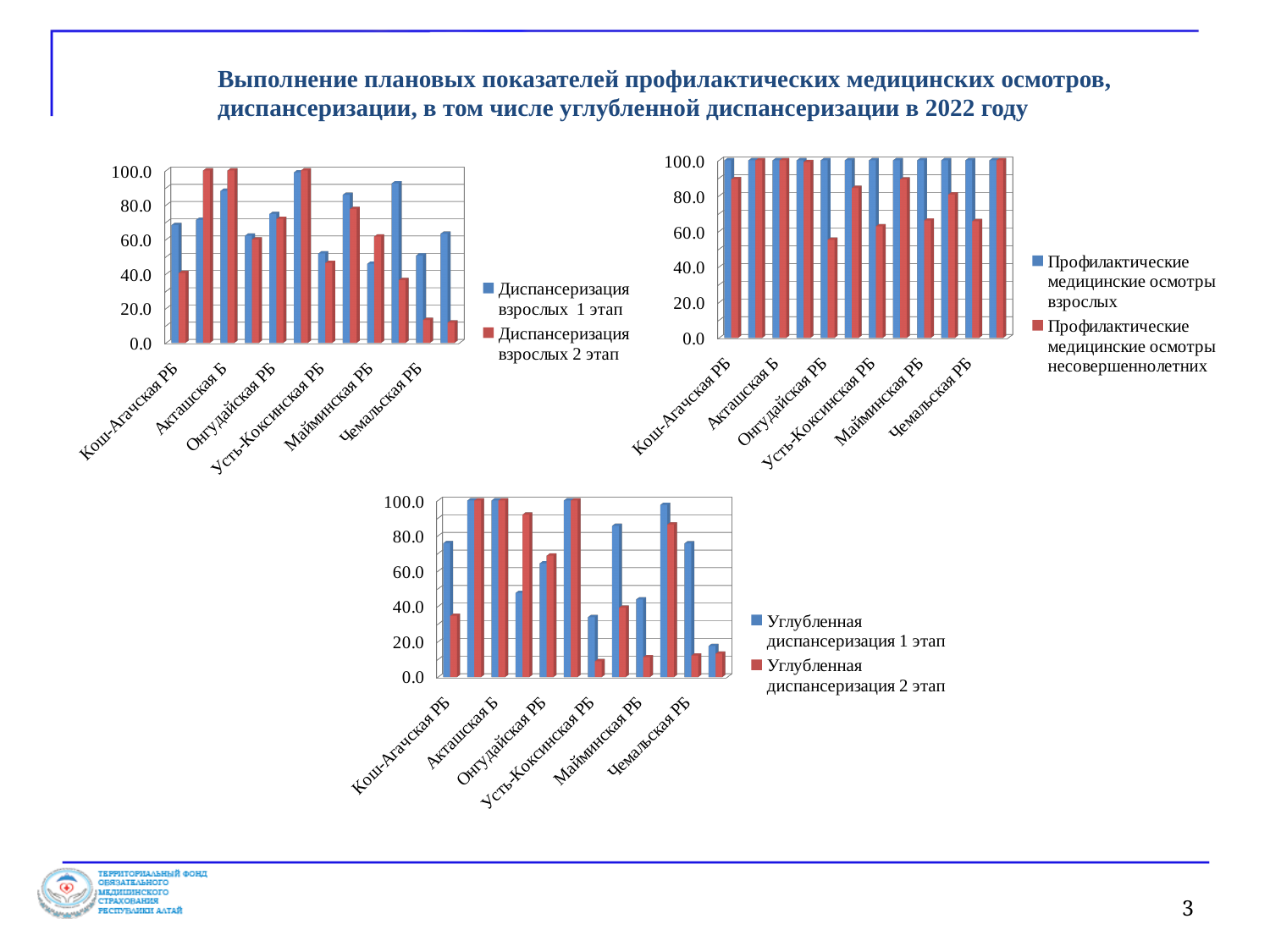
What colour are the bars for 'Углубленная диспансеризация 2 этап' in the bottom chart? red In the top-left chart, is the value of 'Диспансеризация взрослых 1 этап' for Кош-Агачская РБ greater or less than 60? greater In the bottom chart, is the value of 'Углубленная диспансеризация 2 этап' for Кош-Агачская РБ greater or less than 60? less In the top-right chart, is the value of 'Профилактические медицинские осмотры взрослых' for Кош-Агачская РБ greater or less than 80? greater How many series does the legend of the top-right chart list? 2 In the bottom chart, for Кош-Агачская РБ, which series has the larger value: 'Углубленная диспансеризация 1 этап' or 'Углубленная диспансеризация 2 этап'? Углубленная диспансеризация 1 этап How many series does the legend of the bottom chart list? 2 In the top-left chart, for Кош-Агачская РБ, which series has the larger value: 'Диспансеризация взрослых 1 этап' or 'Диспансеризация взрослых 2 этап'? Диспансеризация взрослых 1 этап What kind of chart is the top-left chart on the slide? bar chart In the top-right chart, for Кош-Агачская РБ, which series has the larger value: 'Профилактические медицинские осмотры взрослых' or 'Профилактические медицинские осмотры несовершеннолетних'? Профилактические медицинские осмотры взрослых How many series does the legend of the top-left chart list? 2